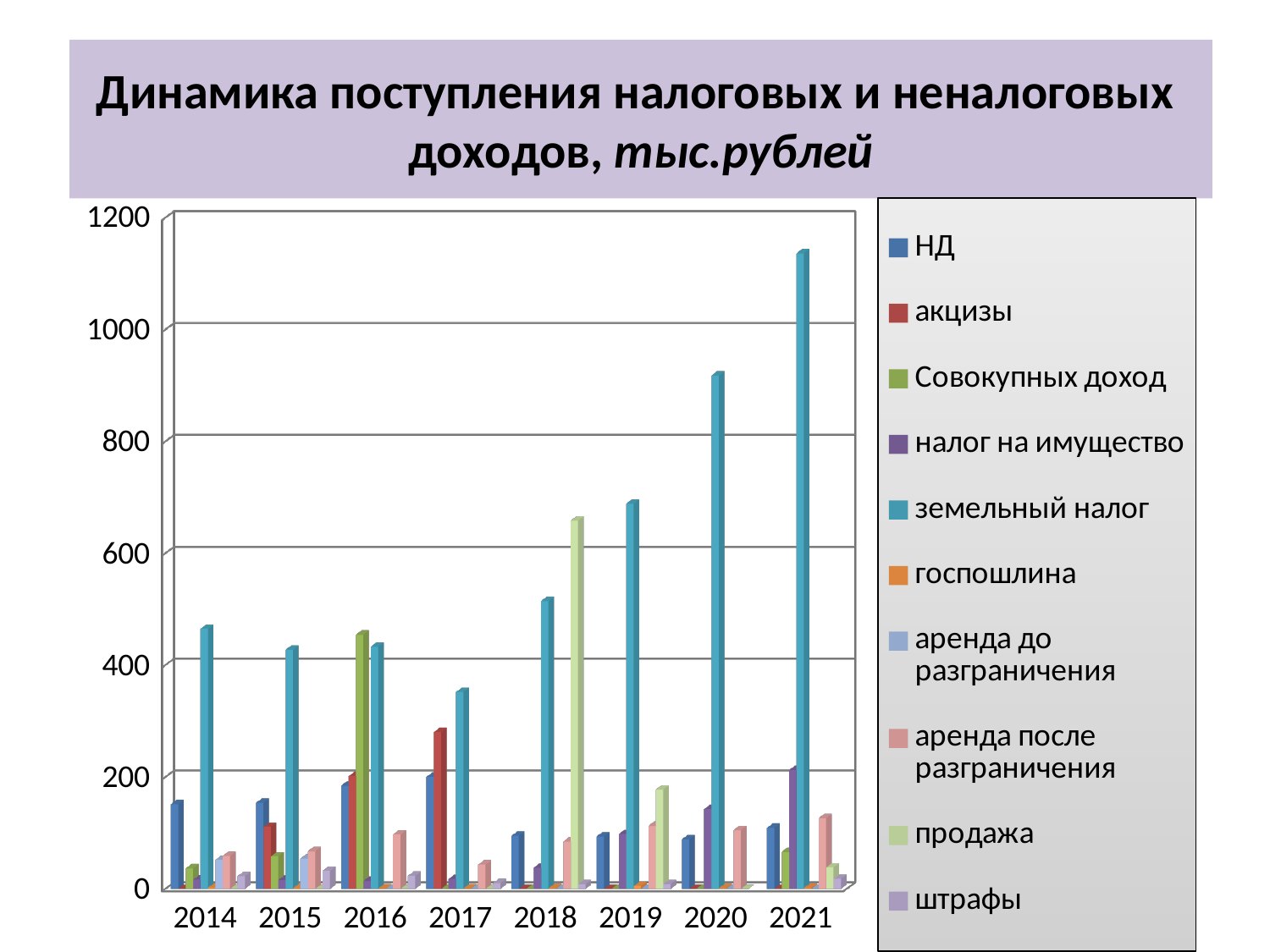
What is the title of the chart? Динамика поступления налоговых и неналоговых доходов, тыс.рублей Is the value for земельный налог in 2020 greater or less than 800? greater How many series does the legend list? 10 How many years are shown on the x axis? 8 Does the value for земельный налог rise or fall from 2017 to 2021? rise Is the value for акцизы in 2017 greater or less than 200? greater Which is larger: земельный налог in 2020 or земельный налог in 2021? 2021 In which year is the value for земельный налог the highest? 2021 Is the value for продажа in 2018 greater or less than 600? greater What kind of chart is shown on the slide? bar chart In which year is the value for земельный налог the lowest? 2017